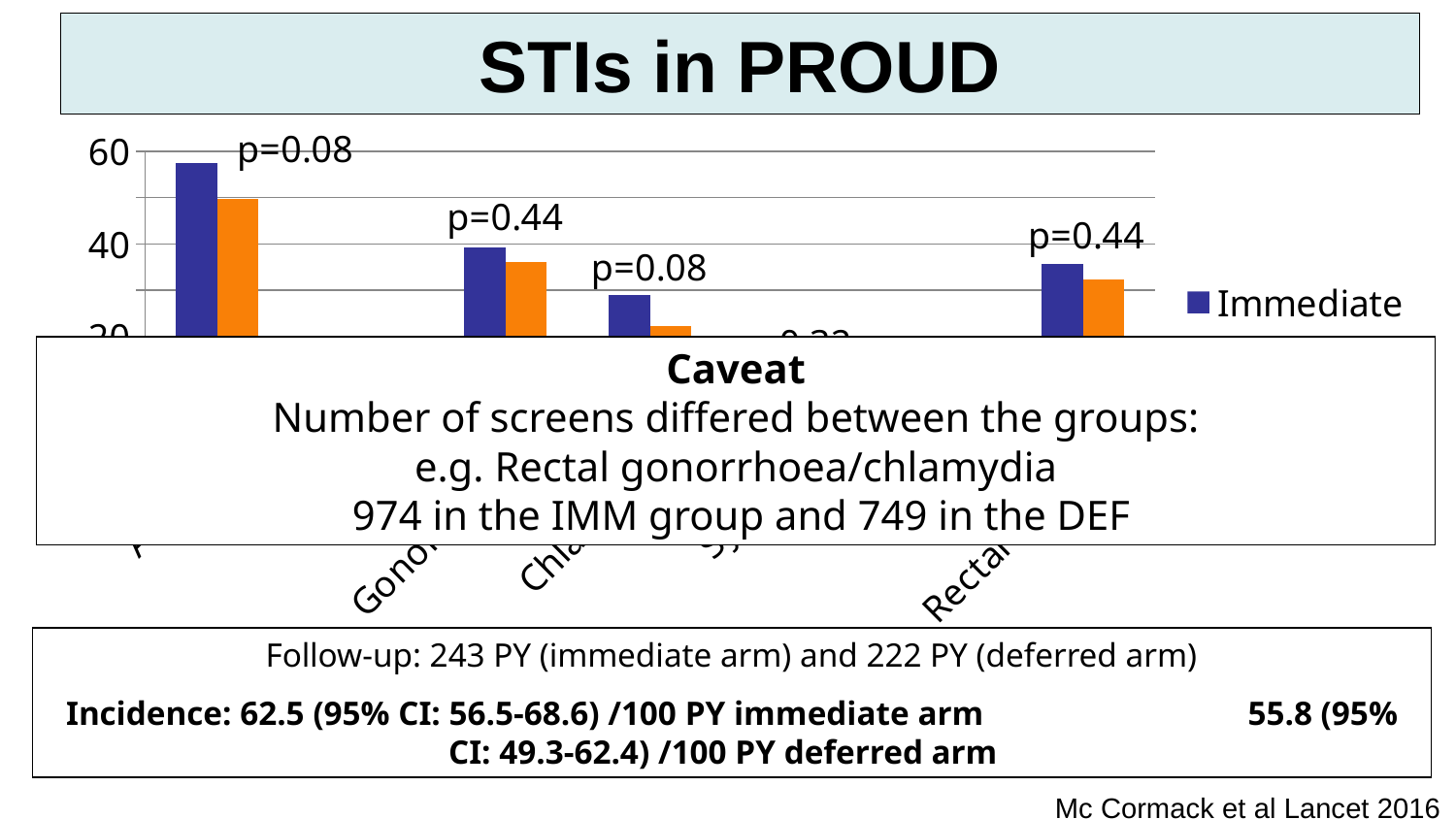
In the leftmost group of bars, which bar is taller, the blue (Immediate) bar or the orange bar? the blue (Immediate) bar In the rightmost group of bars, which bar is taller, the blue (Immediate) bar or the orange bar? the blue (Immediate) bar Is the value of the blue (Immediate) bar in the second group from the left greater or less than 20? greater What kind of chart is shown on the slide? bar chart Which series name is readable in the chart legend? Immediate Is the value of the orange bar in the leftmost group greater or less than 40? greater Is the value of the blue (Immediate) bar in the rightmost group greater or less than 40? less What is the title of the slide containing the chart? STIs in PROUD